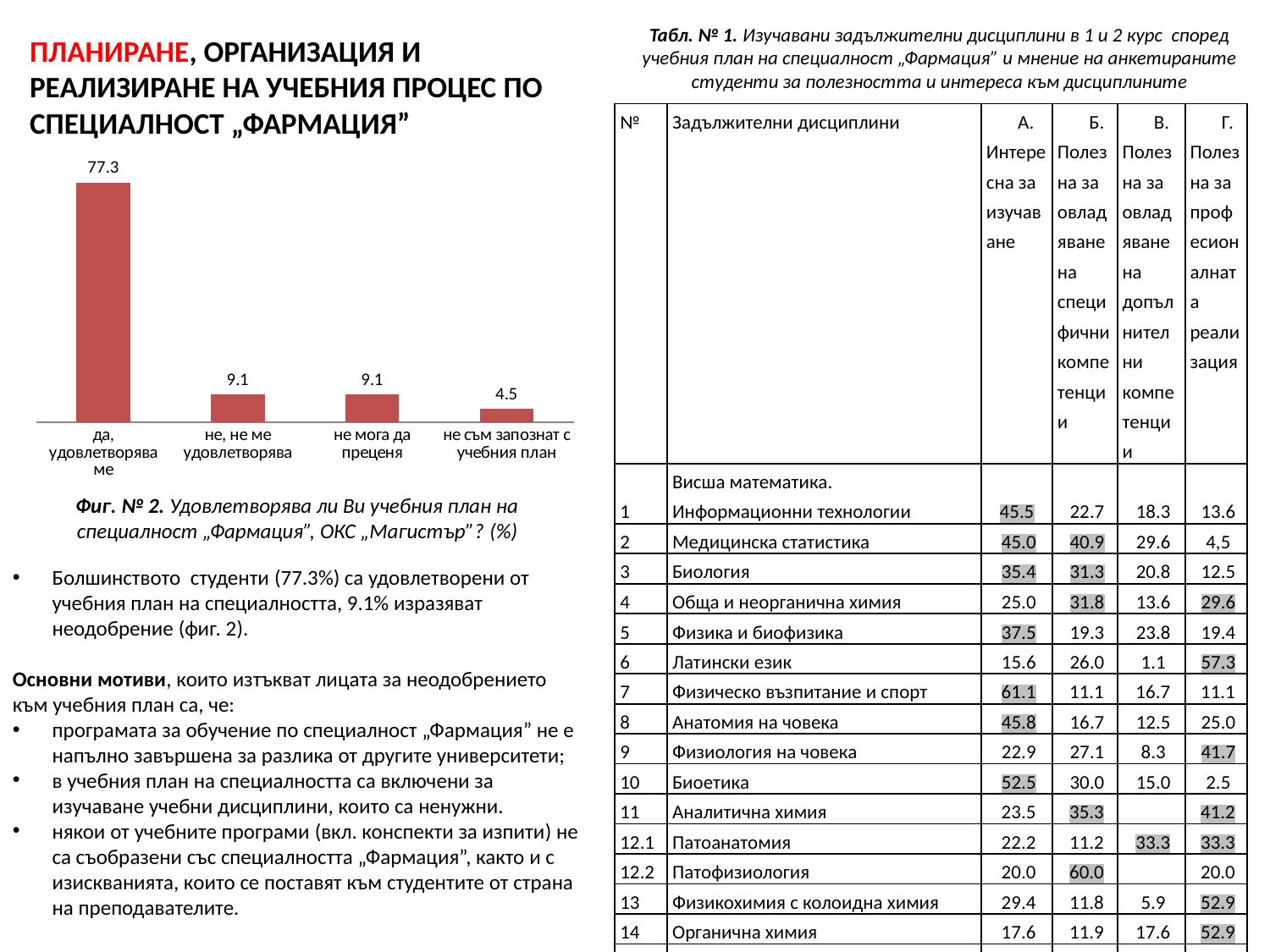
Which category has the lowest value in the bar chart? не съм запознат с учебния план Do the values in the bar chart rise or fall from left to right along the x axis? fall What is the value for the category "не мога да преценя"? 9.1 What is the value for the category "не съм запознат с учебния план"? 4.5 Which category has the highest value in the bar chart? да, удовлетворява ме What kind of chart is shown on the slide? bar chart What is the value for the category "не, не ме удовлетворява"? 9.1 Which is larger: the value for "не, не ме удовлетворява" or the value for "не съм запознат с учебния план"? не, не ме удовлетворява How many categories are shown in the bar chart? 4 What is the value for the category "да, удовлетворява ме"? 77.3 What is the difference between the values for "да, удовлетворява ме" and "не, не ме удовлетворява"? 68.2 What is the difference between the values for "не мога да преценя" and "не съм запознат с учебния план"? 4.6